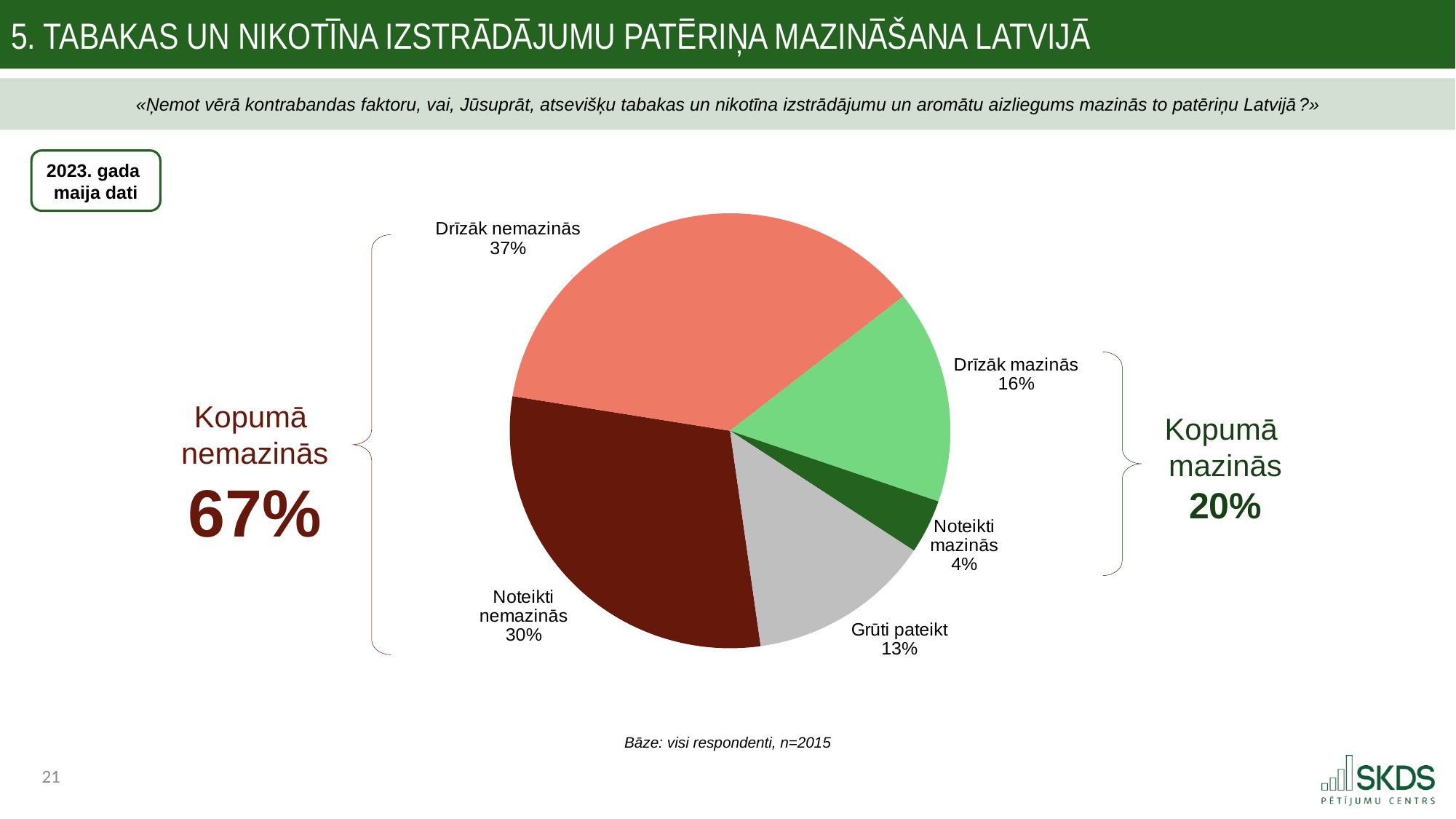
What is the combined share of "Drīzāk mazinās" and "Noteikti mazinās"? 20% Which is larger: the share for "Noteikti nemazinās" or the share for "Grūti pateikt"? Noteikti nemazinās What is the combined share labelled "Kopumā nemazinās" on the slide? 67% How many slices does the pie chart have? 5 What percentage of respondents answered "Drīzāk nemazinās"? 37% Which answer has the smallest share of the pie? Noteikti mazinās What percentage of respondents answered "Noteikti mazinās"? 4% What percentage of respondents answered "Grūti pateikt"? 13% What is the difference in percentage points between "Drīzāk nemazinās" and "Drīzāk mazinās"? 21 What kind of chart is shown on the slide? pie chart Which answer has the largest share of the pie? Drīzāk nemazinās What colour is the "Grūti pateikt" slice? grey